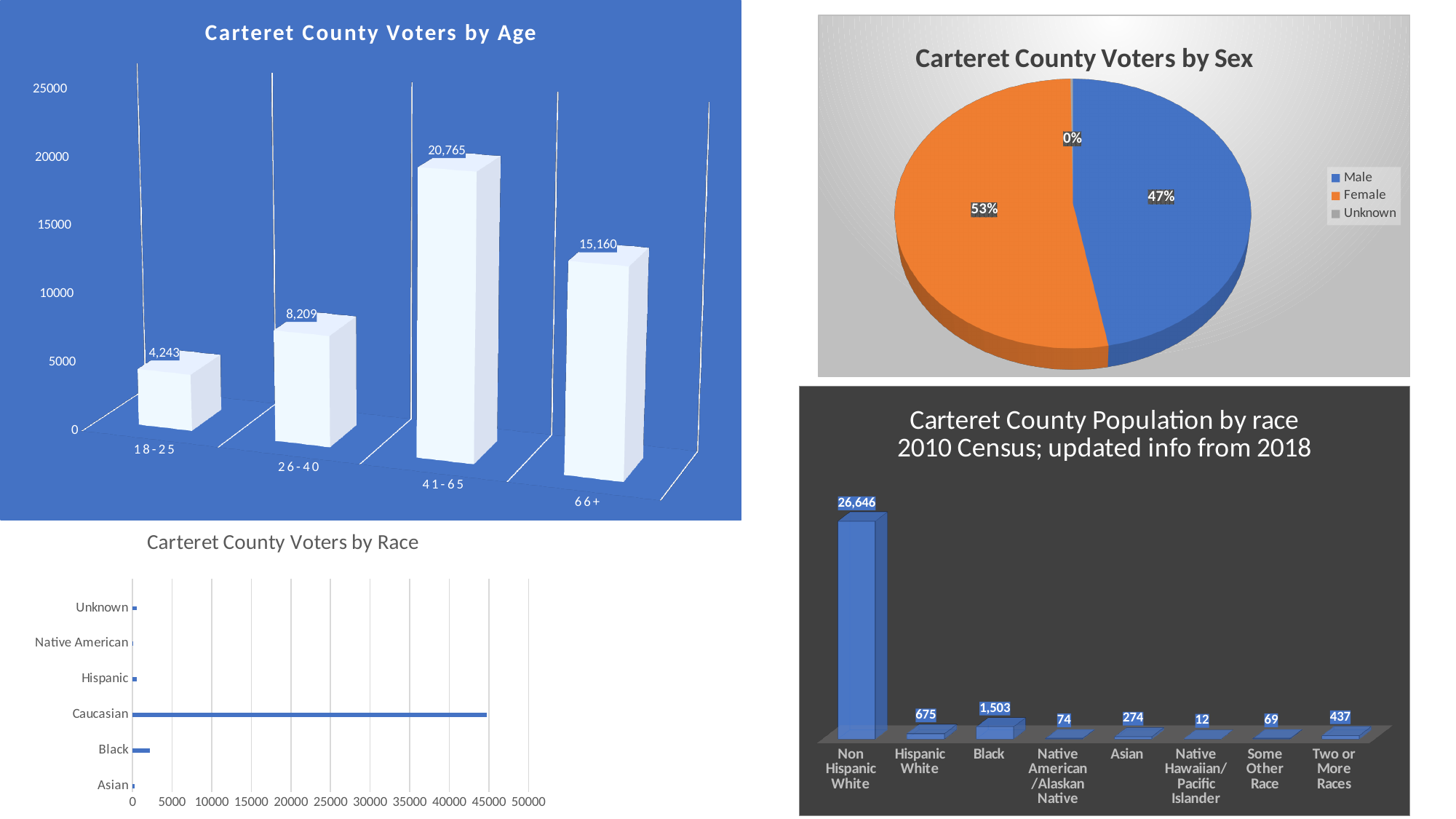
In the 'Carteret County Voters by Race' chart, is the value for Caucasian greater or less than 40000? greater In the 'Carteret County Voters by Sex' chart, how many entries does the legend list? 3 In the 'Carteret County Population by race' chart, what is the value for Black? 1,503 In the 'Carteret County Population by race' chart, which category has the lowest value? Native Hawaiian/Pacific Islander What kind of chart is 'Carteret County Voters by Sex'? pie chart In the 'Carteret County Voters by Race' chart, which category has the highest value? Caucasian In the 'Carteret County Population by race' chart, which is larger, Asian or Two or More Races? Two or More Races In the 'Carteret County Voters by Age' chart, which age group has the lowest number of voters? 18-25 In the 'Carteret County Voters by Age' chart, what is the difference between the 41-65 and 66+ groups? 5,605 In the 'Carteret County Voters by Age' chart, what is the value for the 41-65 age group? 20,765 In the 'Carteret County Voters by Sex' chart, what share of voters is Female? 53% In the 'Carteret County Voters by Age' chart, how many age groups are shown? 4